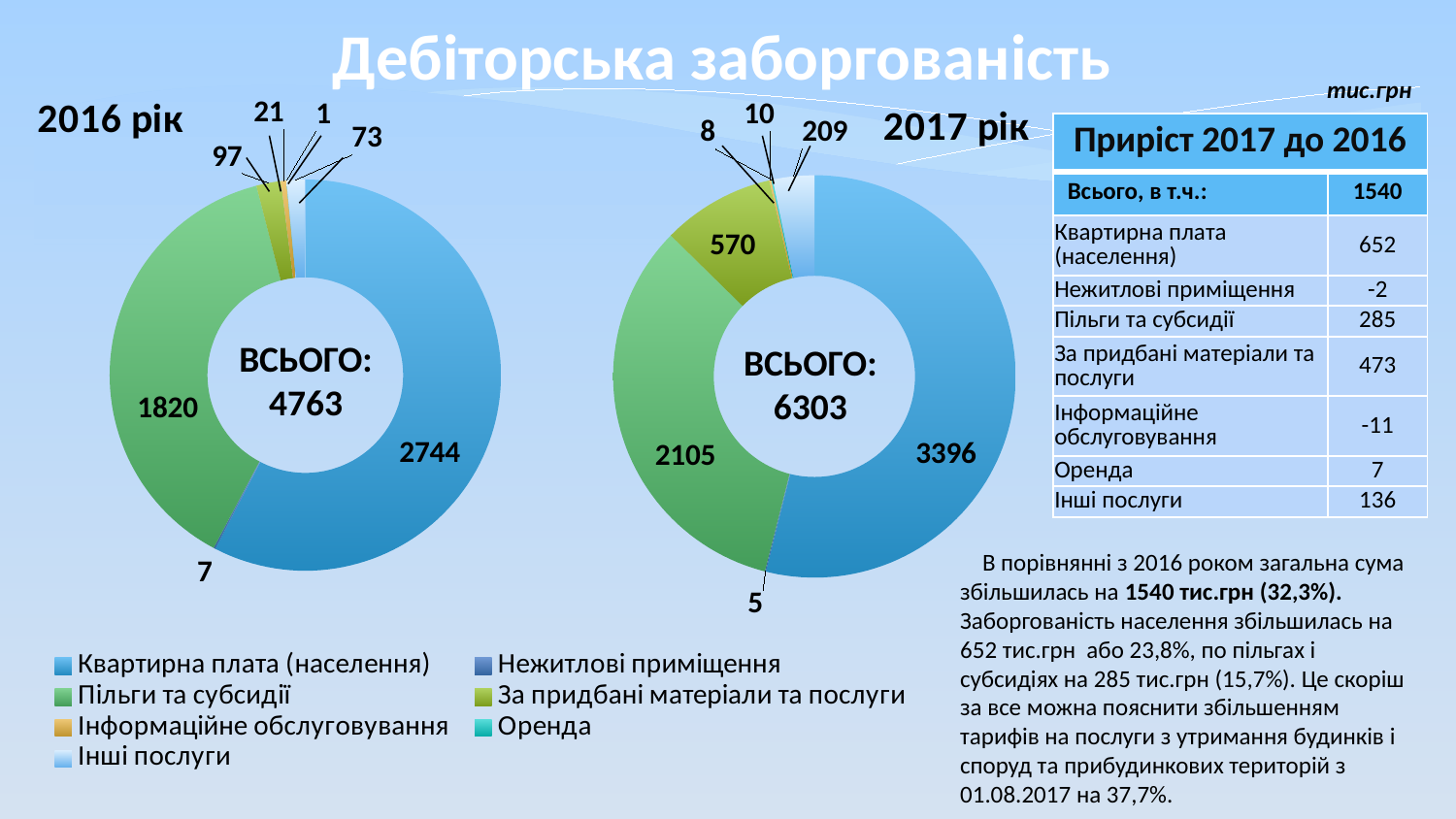
Which is larger: Інші послуги in the 2017 рік chart or Інші послуги in the 2016 рік chart? 2017 рік (209) In the 2016 рік chart, which category has the largest value? Квартирна плата (населення) In the 2016 рік chart, what is the value for Квартирна плата (населення)? 2744 What total is shown in the centre of the 2016 рік chart? 4763 What type of chart is used for the 2016 рік and 2017 рік data? Doughnut (pie) chart In the 2017 рік chart, which category has the smallest value? Нежитлові приміщення What total is shown in the centre of the 2017 рік chart? 6303 How many categories does the legend list for the charts? 7 In the 2017 рік chart, what is the value for За придбані матеріали та послуги? 570 In the 2017 рік chart, what is the value for Пільги та субсидії? 2105 What is the difference between the Квартирна плата (населення) values in the 2017 рік and 2016 рік charts? 652 What unit is indicated for the values on the slide? тис.грн